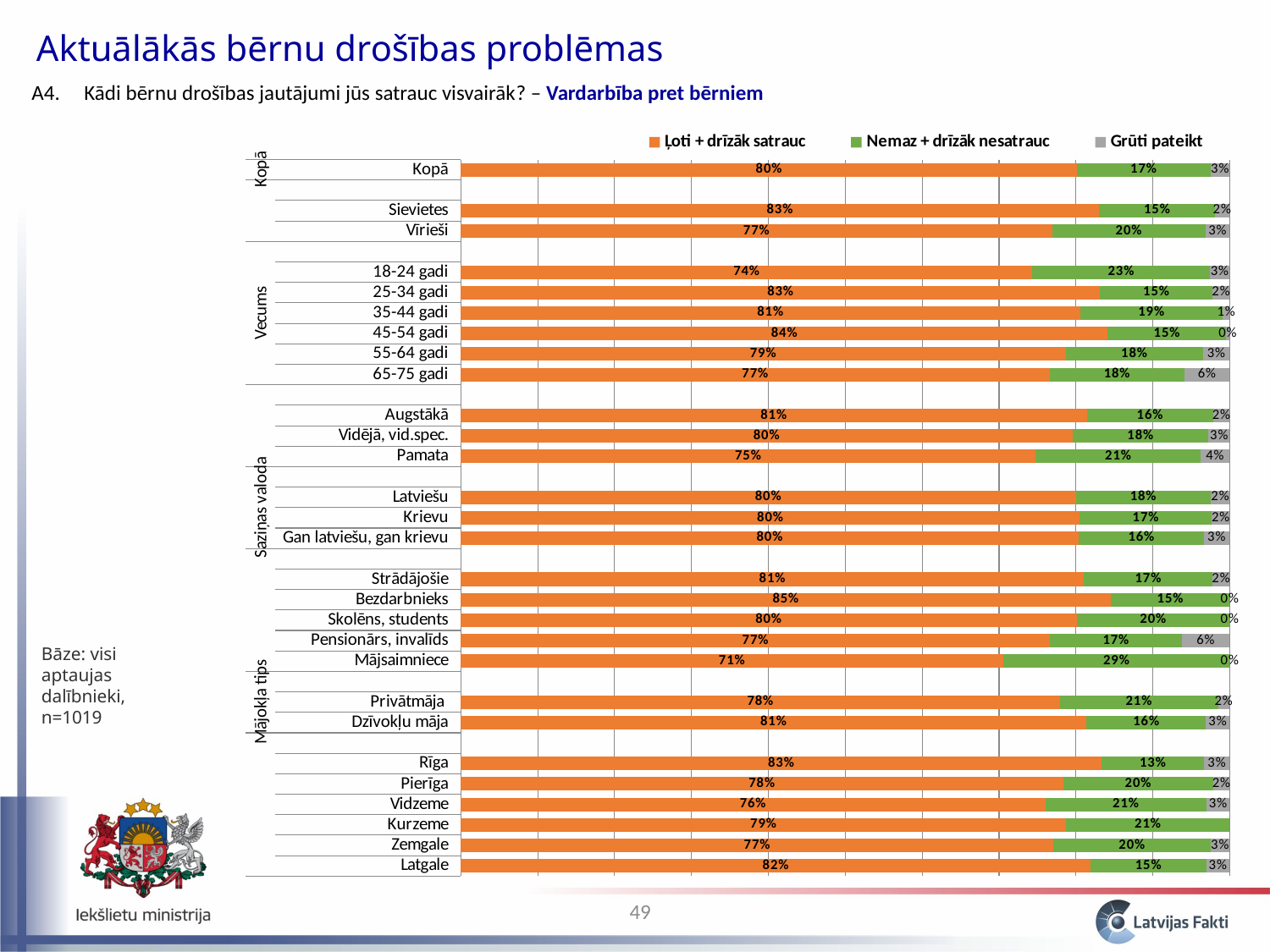
What kind of chart is shown on the slide? Stacked bar chart What is the difference in "Ļoti + drīzāk satrauc" between Sievietes and Vīrieši? 6 percentage points What is the value of "Nemaz + drīzāk nesatrauc" for Rīga? 13% Which category has the highest value for "Ļoti + drīzāk satrauc"? Bezdarbnieks What is the total of the stacked bar for Kopā? 100% What colour represents "Grūti pateikt" in the chart? Grey What is the value of "Ļoti + drīzāk satrauc" for Mājsaimniece? 71% Which category has the lowest value for "Ļoti + drīzāk satrauc"? Mājsaimniece What is the value of "Grūti pateikt" for 65-75 gadi? 6% Which has a larger "Ļoti + drīzāk satrauc" value, 18-24 gadi or 45-54 gadi? 45-54 gadi What is the value of "Ļoti + drīzāk satrauc" for Kopā? 80% How many series does the legend list? 3